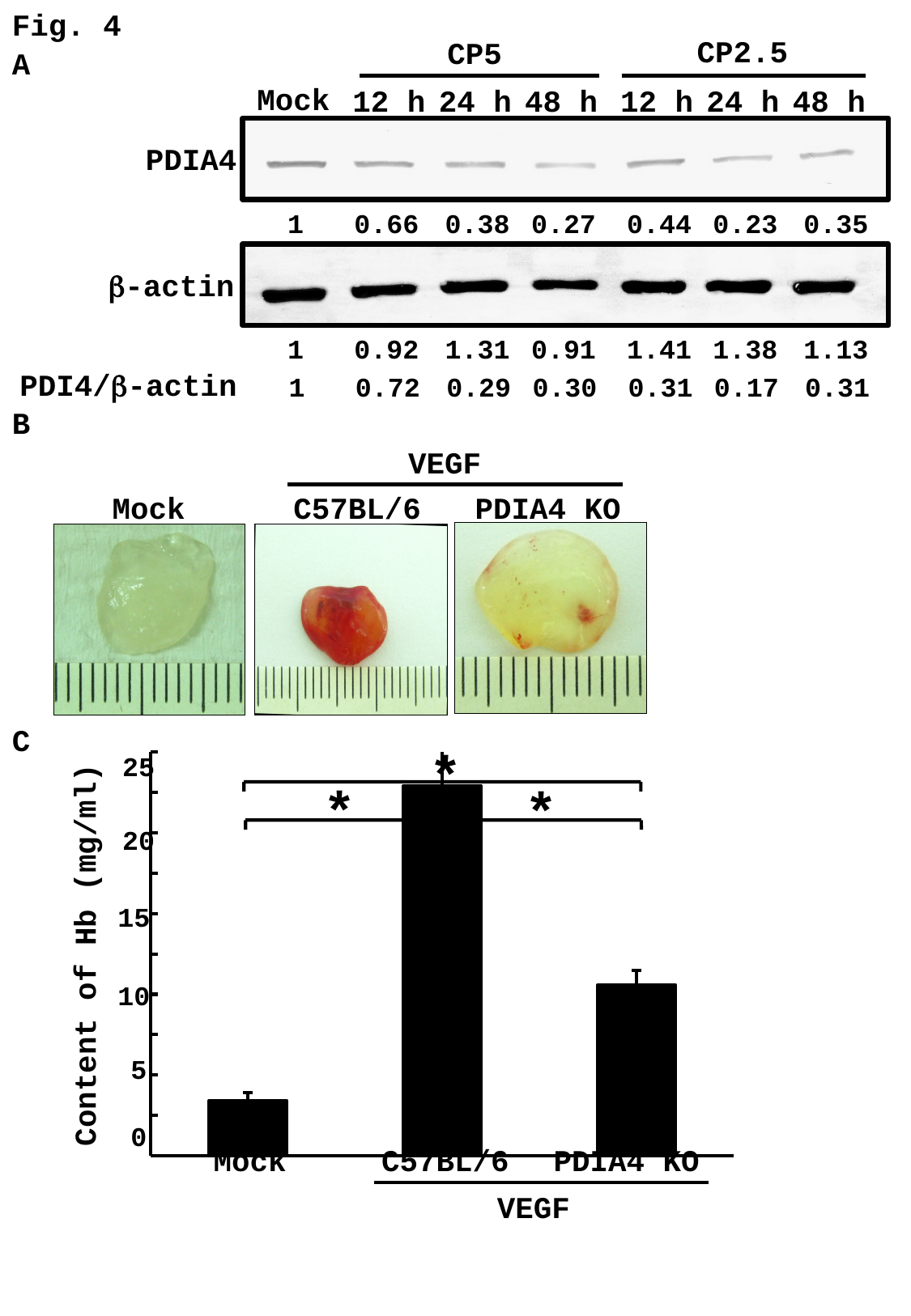
In panel C, how many bars (categories) are plotted? 3 In panel C, what kind of chart is shown? bar chart In panel C, is the value for C57BL/6 greater or less than 20? greater In panel C, is the value for C57BL/6 greater or less than 25? less In panel C, is the value for PDIA4 KO greater or less than 15? less In panel C, what is the label of the y-axis? Content of Hb (mg/ml) In panel C, which category has the lowest content of Hb? Mock In panel C, which has a larger content of Hb, Mock or PDIA4 KO? PDIA4 KO In panel C, which has a larger content of Hb, C57BL/6 or PDIA4 KO? C57BL/6 In panel C, which categories are grouped under the VEGF label on the x-axis? C57BL/6 and PDIA4 KO In panel C, which category has the highest content of Hb? C57BL/6